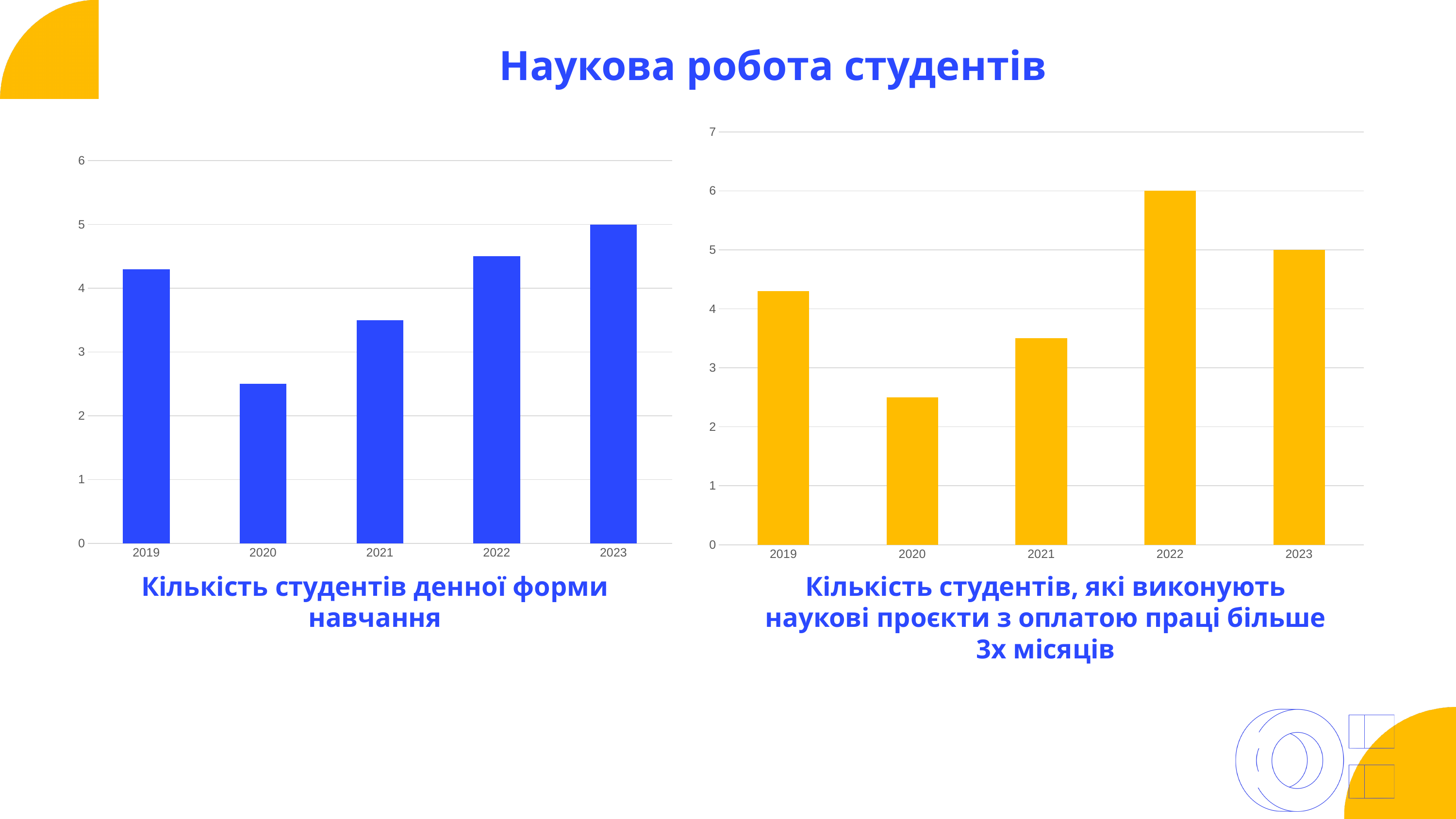
How many years are shown on the x axis of the left chart, 'Кількість студентів денної форми навчання'? 5 In the left chart, 'Кількість студентів денної форми навчання', which year has the lowest value? 2020 In the right chart, 'Кількість студентів, які виконують наукові проєкти з оплатою праці більше 3х місяців', which year has the highest value? 2022 In the right chart, 'Кількість студентів, які виконують наукові проєкти з оплатою праці більше 3х місяців', which year has the lowest value? 2020 In the left chart, 'Кількість студентів денної форми навчання', which year has the highest value? 2023 In the right chart, 'Кількість студентів, які виконують наукові проєкти з оплатою праці більше 3х місяців', what is the value for 2022? 6 In the right chart, 'Кількість студентів, які виконують наукові проєкти з оплатою праці більше 3х місяців', what is the difference between the values for 2022 and 2023? 1 In the left chart, 'Кількість студентів денної форми навчання', is the value for 2020 greater or less than 3? less In the left chart, 'Кількість студентів денної форми навчання', what is the value for 2023? 5 In the right chart, 'Кількість студентів, які виконують наукові проєкти з оплатою праці більше 3х місяців', what is the value for 2023? 5 What kind of chart is the left chart, 'Кількість студентів денної форми навчання'? bar chart In the right chart, 'Кількість студентів, які виконують наукові проєкти з оплатою праці більше 3х місяців', which year has the larger value, 2019 or 2021? 2019